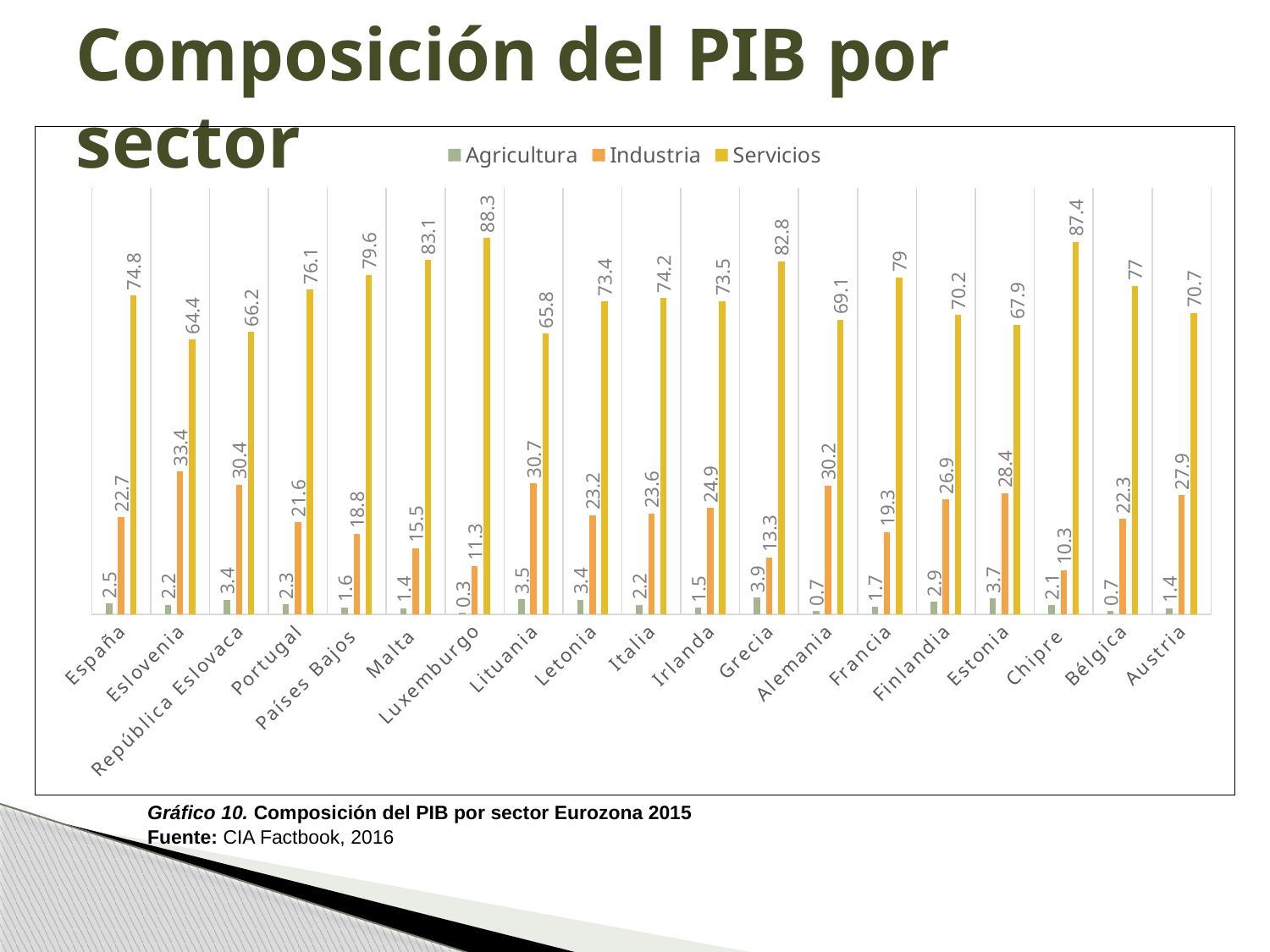
How many series does the legend list? 3 What is the Industria value for Eslovenia? 33.4 What kind of chart is shown on the slide? Bar chart Which is larger, the Industria value for Alemania or for Francia? Alemania What is the difference between the Servicios values of Luxemburgo and Eslovenia? 23.9 What is the Servicios value for Luxemburgo? 88.3 What is the Agricultura value for Grecia? 3.9 What is the Servicios value for Chipre? 87.4 How many countries are shown on the x axis? 19 Which country has the lowest Industria value? Chipre Which country has the lowest Servicios value? Eslovenia Which country has the highest Servicios value? Luxemburgo